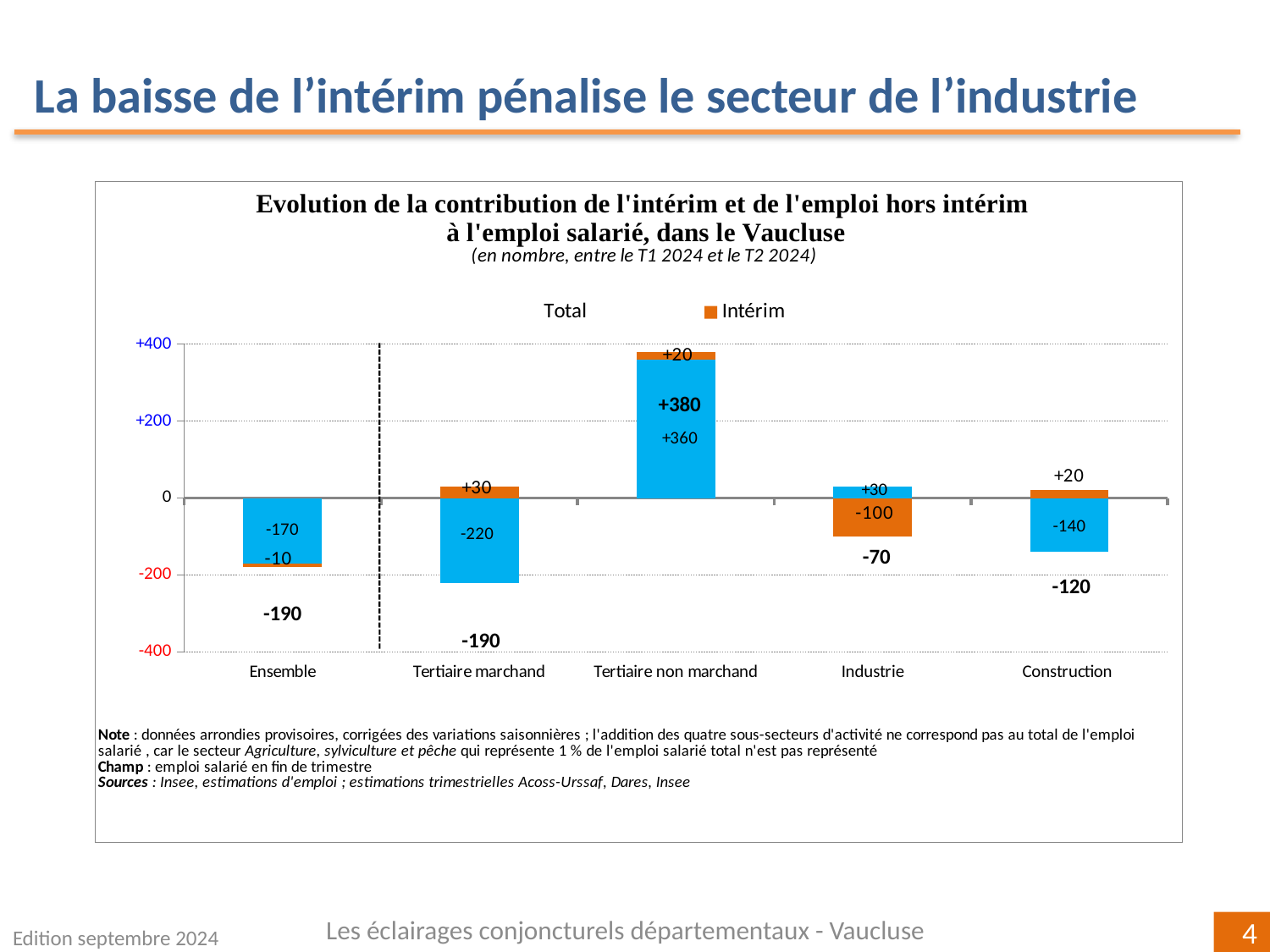
What is the difference between the total for Tertiaire non marchand (+380) and the total for Construction (-120)? 500 What is the value of the blue (non-Intérim) segment for Construction? -140 How many categories are shown on the x axis? 5 What is the total value shown for Tertiaire non marchand? +380 What kind of chart is shown on the slide? Stacked bar chart What is the Intérim value for Industrie? -100 How many series does the legend list? 2 Which is larger, the Intérim value for Tertiaire marchand or the Intérim value for Tertiaire non marchand? Tertiaire marchand What is the total value shown for Industrie? -70 Which category has the highest total value? Tertiaire non marchand What is the Intérim value for Tertiaire marchand? +30 Which category has the lowest Intérim value? Industrie